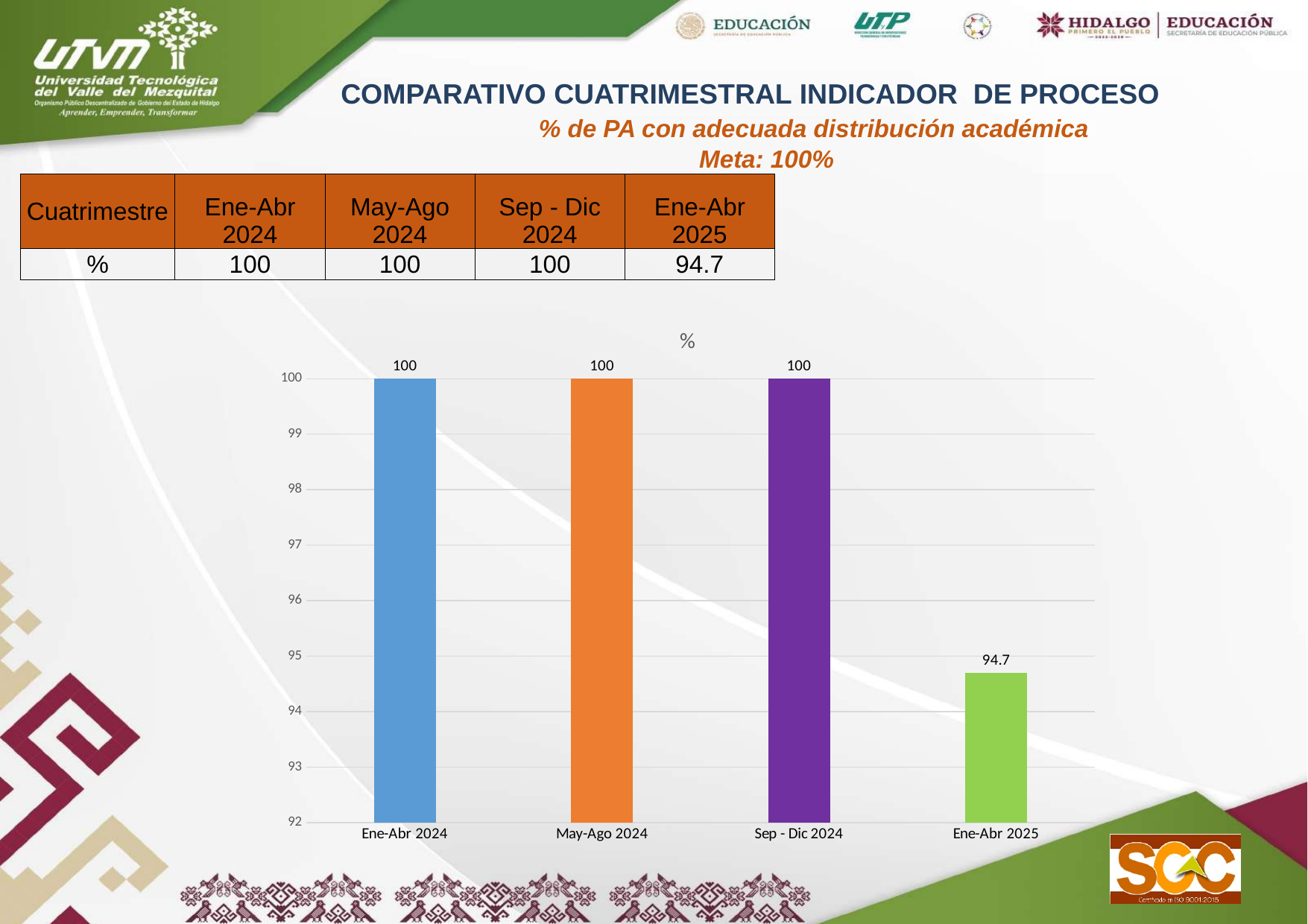
What is the value for Ene-Abr 2025 in the chart? 94.7 What kind of chart is shown on the slide? bar chart What is the value for May-Ago 2024 in the chart? 100 What colour is the bar for Ene-Abr 2025? green Is the value for Ene-Abr 2025 greater or less than 95? less Which category has the lowest value in the chart? Ene-Abr 2025 What is the difference between the values for Sep - Dic 2024 and Ene-Abr 2025? 5.3 Do the values rise or fall from Sep - Dic 2024 to Ene-Abr 2025? fall How many categories have a value of 100 in the chart? 3 What is the title of the chart? % How many categories are shown on the x axis of the chart? 4 Which is larger, the value for Ene-Abr 2024 or the value for Ene-Abr 2025? Ene-Abr 2024